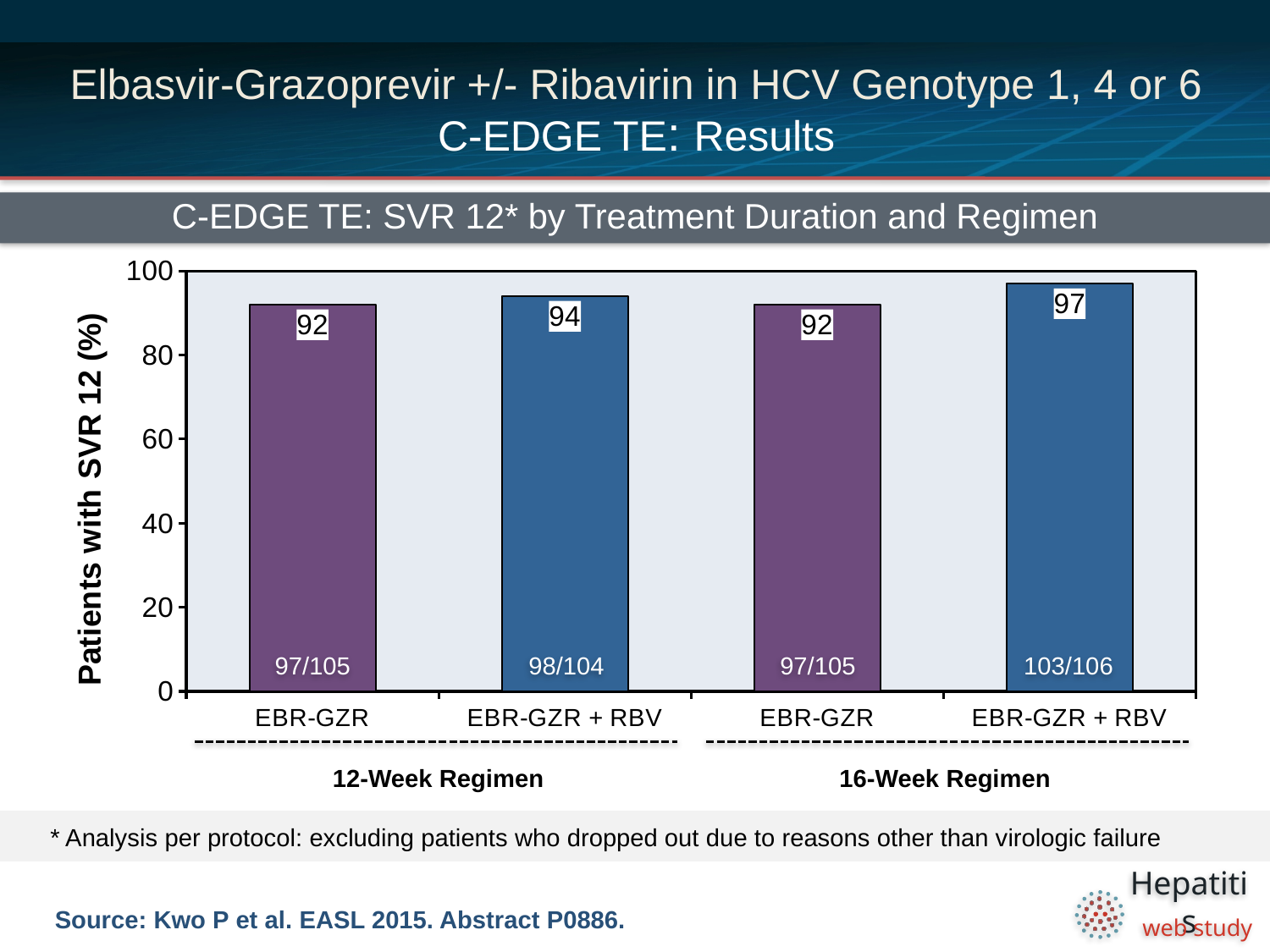
What is the difference in SVR 12 rate between EBR-GZR + RBV in the 16-Week Regimen and EBR-GZR in the 12-Week Regimen? 5 What is the label of the y-axis? Patients with SVR 12 (%) Which bar has the highest SVR 12 rate? EBR-GZR + RBV, 16-Week Regimen What type of chart is shown on the slide? Bar chart How many bars are shown in the chart? 4 What is the SVR 12 rate for EBR-GZR + RBV in the 16-Week Regimen? 97 Which has a higher SVR 12 rate: EBR-GZR + RBV in the 12-Week Regimen or EBR-GZR + RBV in the 16-Week Regimen? EBR-GZR + RBV in the 16-Week Regimen Is the SVR 12 rate for EBR-GZR in the 16-Week Regimen greater or less than 80? greater What is the SVR 12 rate for EBR-GZR + RBV in the 12-Week Regimen? 94 What is the title of the chart? C-EDGE TE: SVR 12* by Treatment Duration and Regimen What fraction of patients is shown for EBR-GZR + RBV in the 16-Week Regimen? 103/106 What is the SVR 12 rate for EBR-GZR in the 12-Week Regimen? 92